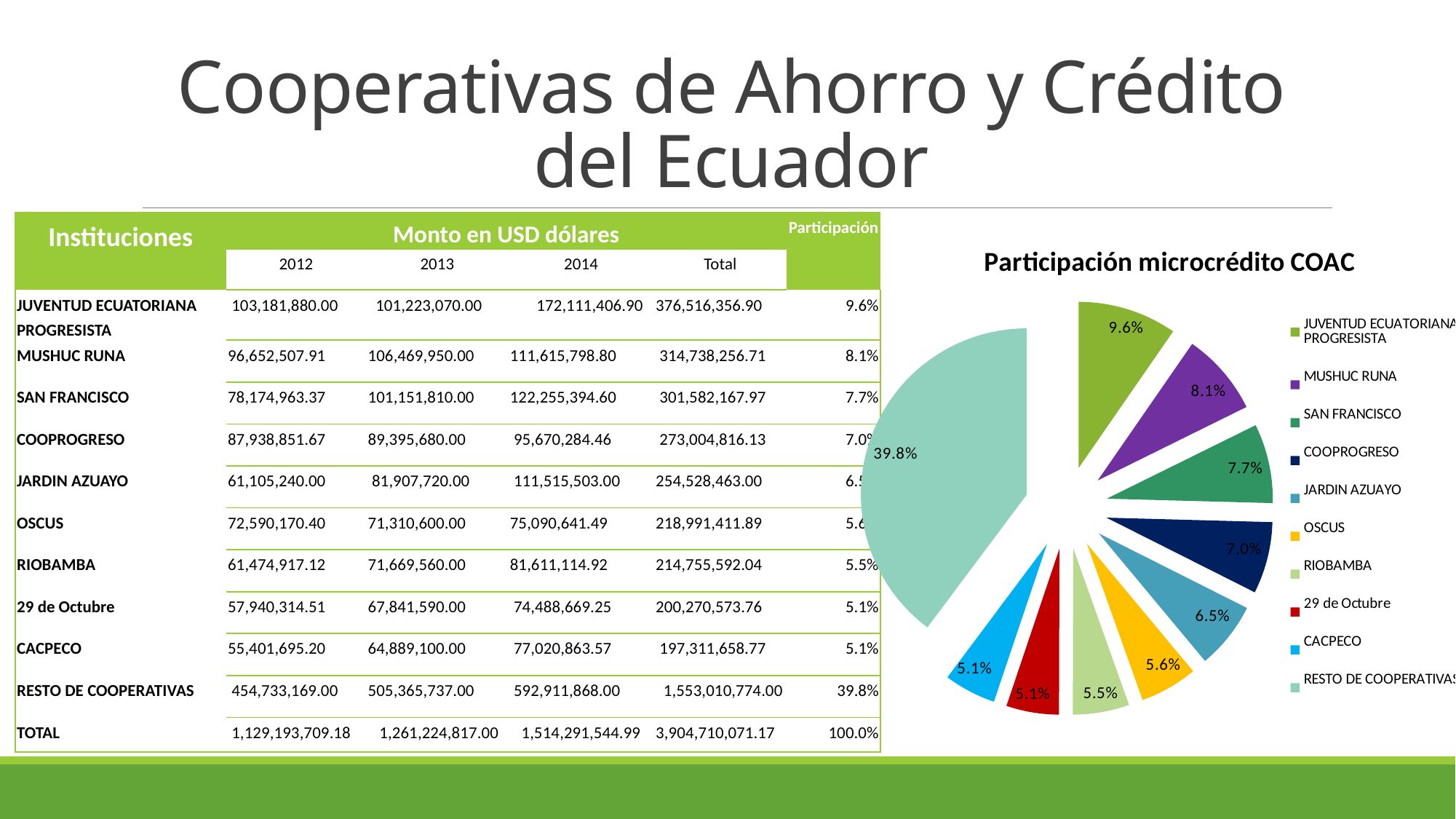
What type of chart is shown on the slide? Pie chart How many entries does the legend of the pie chart list? 10 What is the title of the chart? Participación microcrédito COAC What share of the pie does RESTO DE COOPERATIVAS have? 39.8% What is the difference between the shares of JUVENTUD ECUATORIANA PROGRESISTA and SAN FRANCISCO? 1.9% What is the value shown for MUSHUC RUNA in the pie chart? 8.1% Which slice of the pie chart is the largest? RESTO DE COOPERATIVAS Which slice of the pie chart is the smallest among the named cooperatives, excluding the two tied at 5.1%? RIOBAMBA What is the value shown for JARDIN AZUAYO in the pie chart? 6.5% Which has a larger share, COOPROGRESO or OSCUS? COOPROGRESO How many slices does the pie chart have? 10 What is the value shown for CACPECO in the pie chart? 5.1%